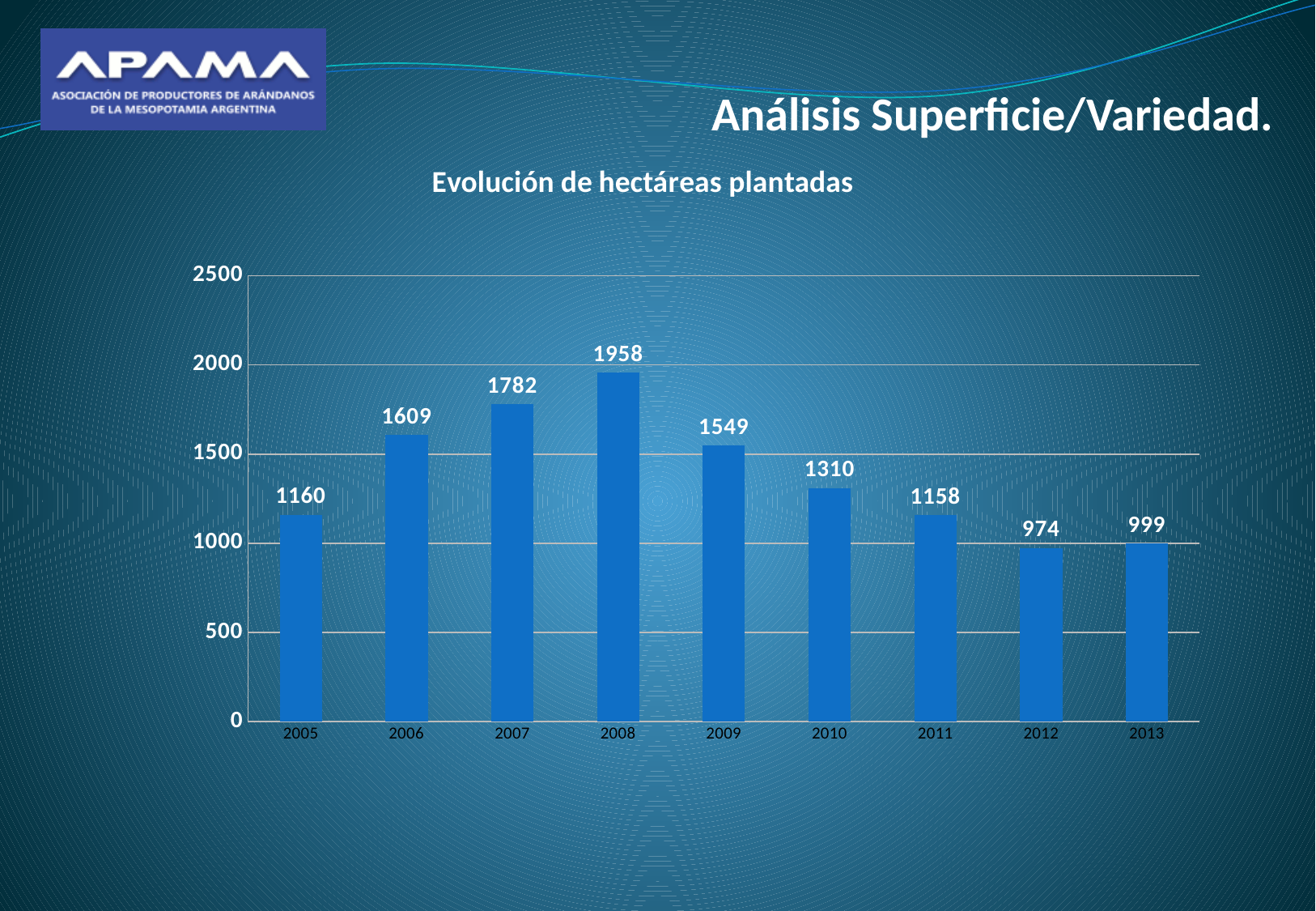
What is the title of the chart? Evolución de hectáreas plantadas Which is larger, the value for 2006 or the value for 2009? 2006 What is the difference between the values for 2008 and 2007? 176 What is the value for 2005? 1160 Which year has the lowest value? 2012 Is the value for 2011 greater or less than 1000? greater What is the value for 2008? 1958 How many years are shown on the x axis? 9 What kind of chart is shown on the slide? bar chart Which year has the highest value? 2008 What is the value for 2012? 974 What is the difference between the values for 2009 and 2010? 239